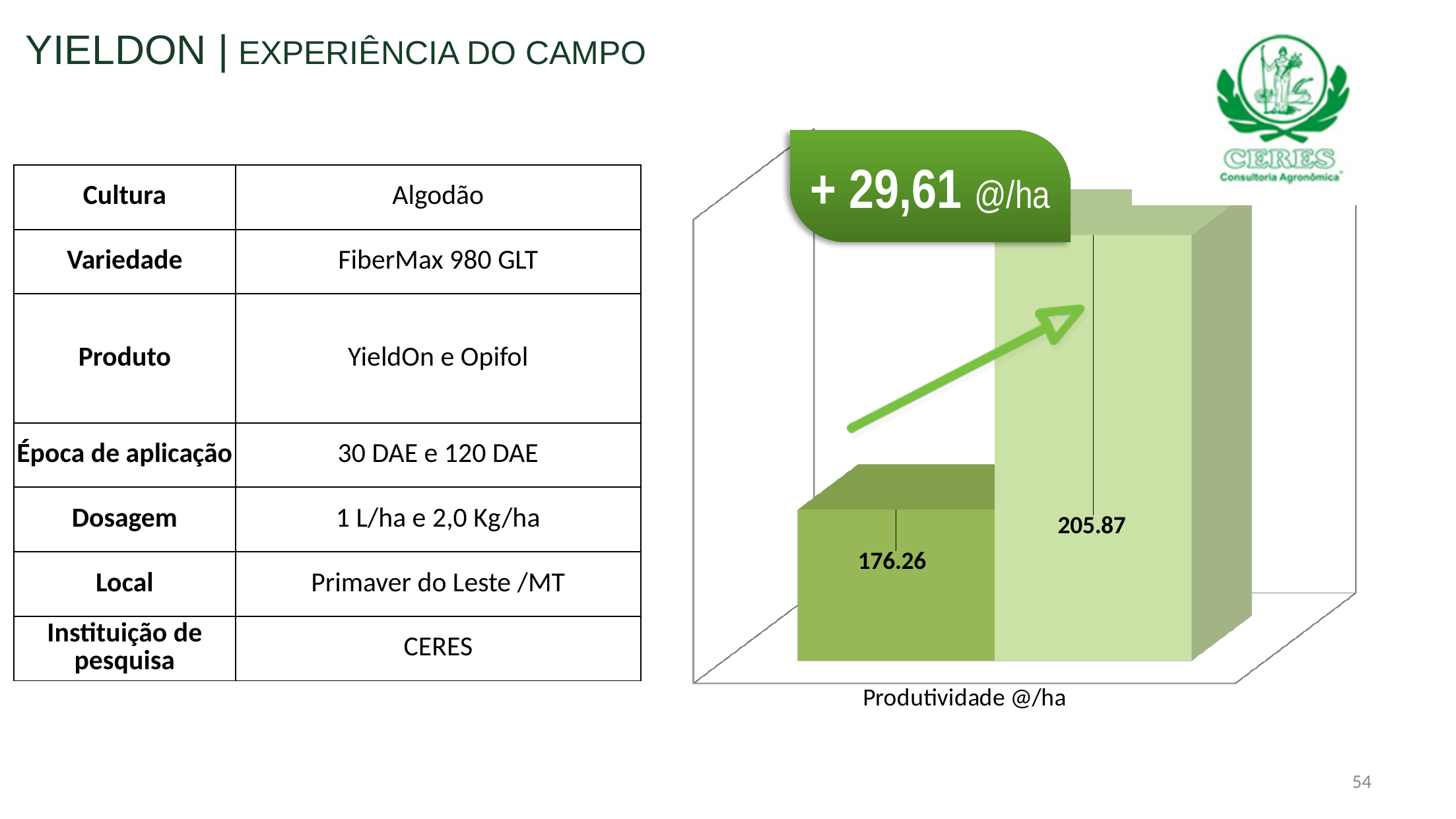
What is the difference between the two bar values shown in the chart? 29.61 What is the label shown on the category axis of the chart? Produtividade @/ha What kind of chart is shown on the slide? bar chart What value is printed on the right (lighter green) bar of the chart? 205.87 What gain is stated in the green callout above the chart? + 29,61 @/ha Which bar in the chart has the lowest value, the left or the right one? the left bar (176.26) What value is printed on the left (darker green) bar of the chart? 176.26 Which bar in the chart has the highest value, the left or the right one? the right bar (205.87) How many bars are plotted in the chart? 2 Is the value of the right bar larger or smaller than the value of the left bar? larger